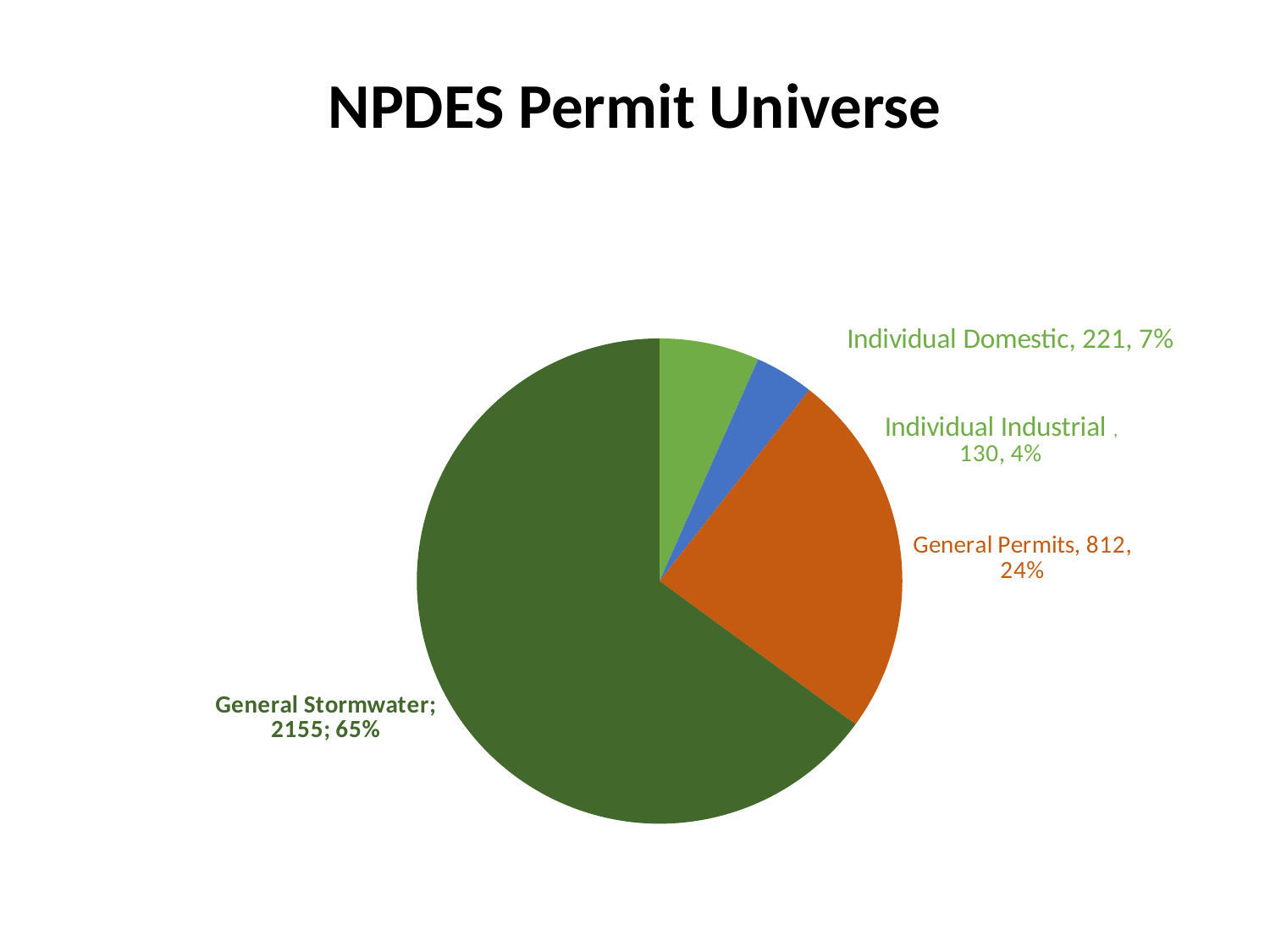
What is the value for Individual Industrial? 130 Which category has the largest slice? General Stormwater What is the difference between the General Stormwater and General Permits values? 1343 What is the value for Individual Domestic? 221 What is the title of the chart? NPDES Permit Universe How many slices does the pie chart have? 4 What is the value for General Stormwater? 2155 What type of chart is shown on the slide? pie chart Which is larger, Individual Domestic or Individual Industrial? Individual Domestic What is the value for General Permits? 812 What share of the pie does General Permits represent? 24% Which category has the smallest slice? Individual Industrial